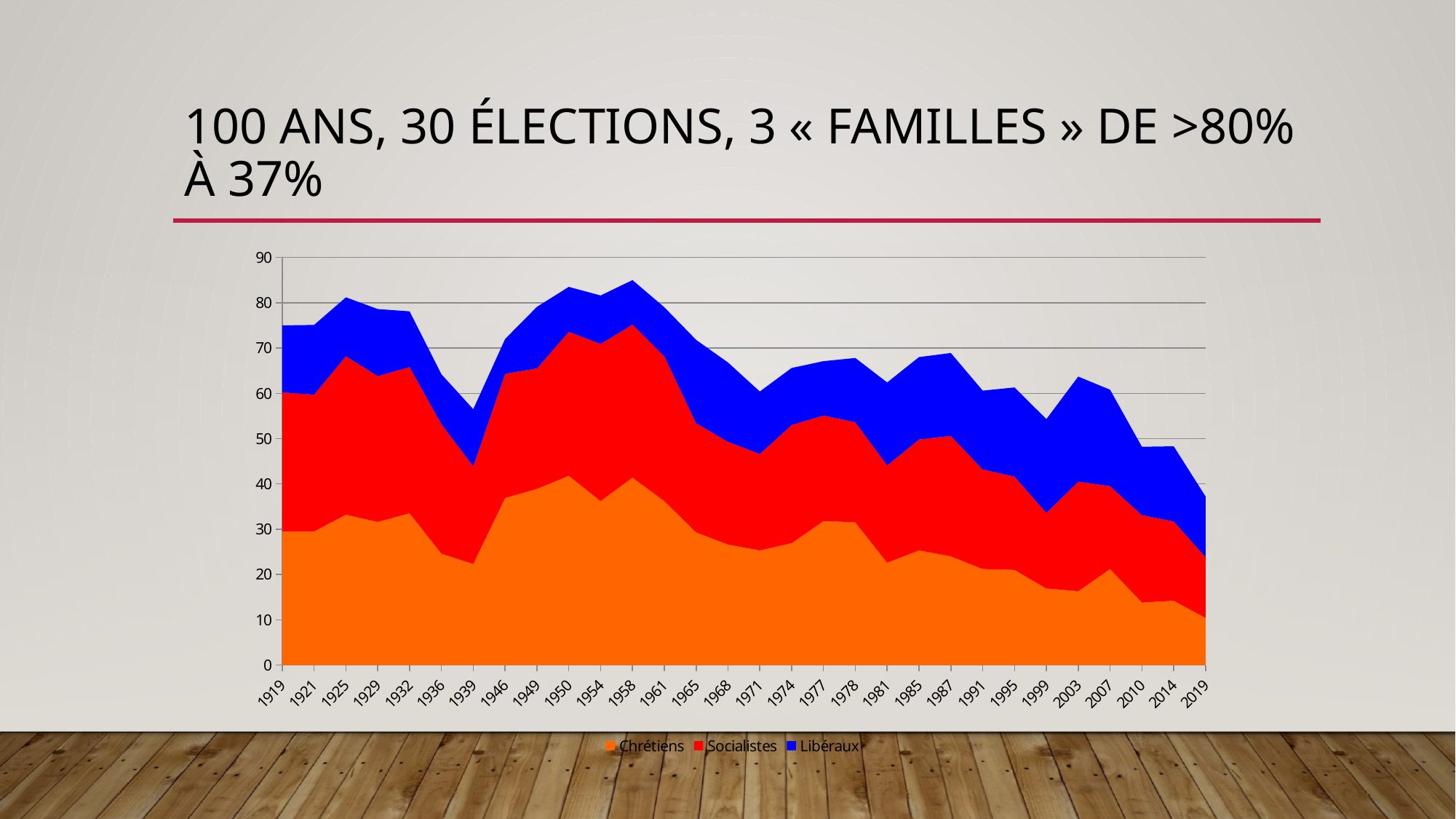
How many election years are shown along the x axis? 30 Does the combined total of the three families rise or fall overall from 1919 to 2019? Fall Is the combined total of the three families in 1939 greater or less than 60? less How many series does the legend list? 3 Which series is shown in blue? Libéraux In which year is the combined total of the three families lowest? 2019 Is the value for Chrétiens larger in 1950 or in 2019? 1950 Is the value for Chrétiens in 1939 greater or less than 30? less Which series is shown in orange at the bottom of the stack? Chrétiens Is the combined total of the three families in 1958 greater or less than 80? greater What kind of chart is shown on the slide? Stacked area chart